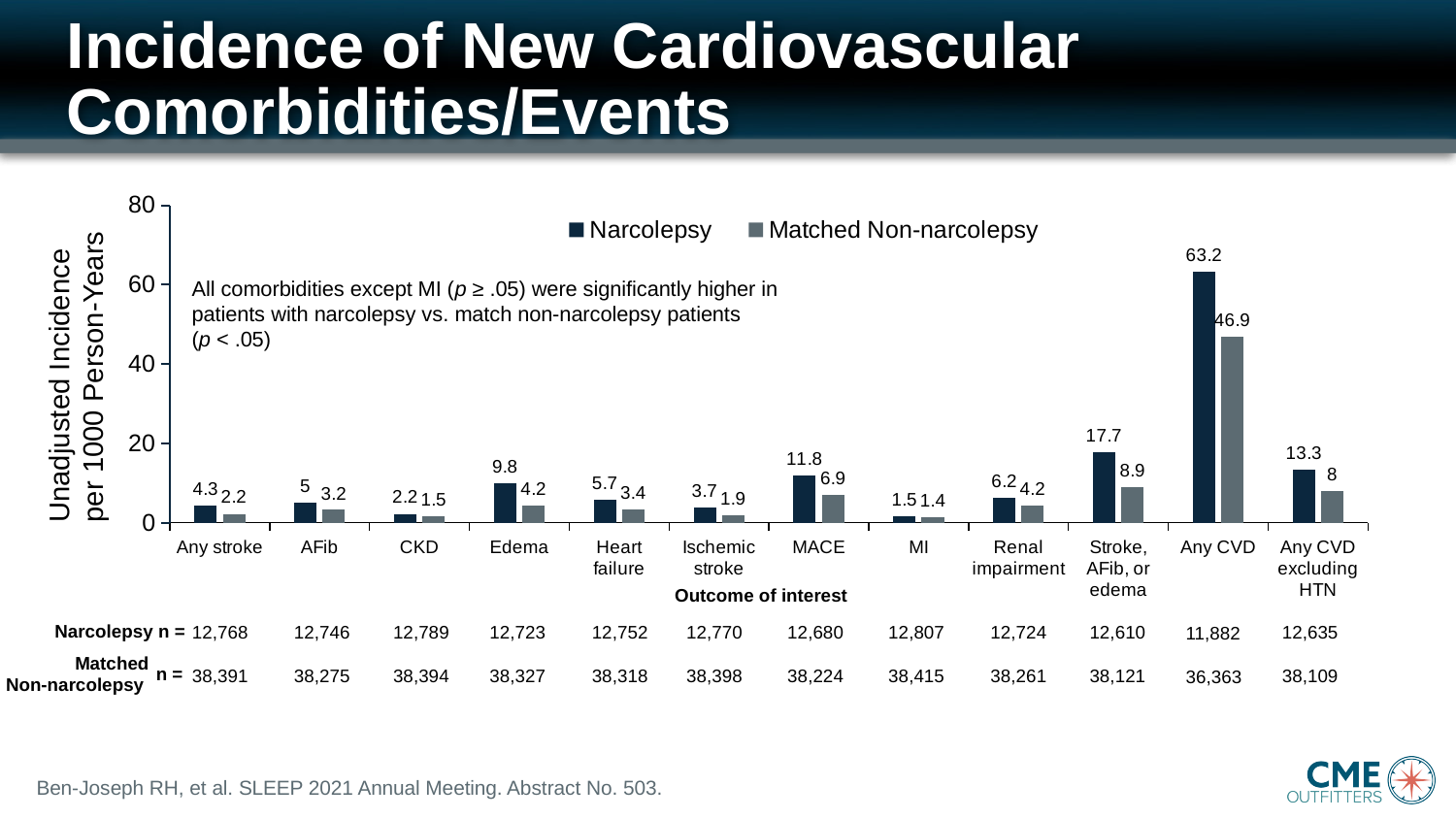
What kind of chart is shown on the slide? Bar chart What is the unadjusted incidence of Any CVD for the Narcolepsy group? 63.2 Which outcome of interest has the lowest unadjusted incidence for the Matched Non-narcolepsy group? MI What is the unadjusted incidence of Edema for the Narcolepsy group? 9.8 What is the difference between the Narcolepsy and Matched Non-narcolepsy values for Stroke, AFib, or edema? 8.8 Which outcome of interest has the highest unadjusted incidence for the Narcolepsy group? Any CVD What is the y-axis label of the chart? Unadjusted Incidence per 1000 Person-Years Which is larger for Heart failure: the Narcolepsy value or the Matched Non-narcolepsy value? Narcolepsy What is the difference between the Narcolepsy and Matched Non-narcolepsy values for Any CVD? 16.3 How many outcomes of interest are shown on the x axis? 12 What is the unadjusted incidence of MACE for the Matched Non-narcolepsy group? 6.9 How many series does the legend list? 2